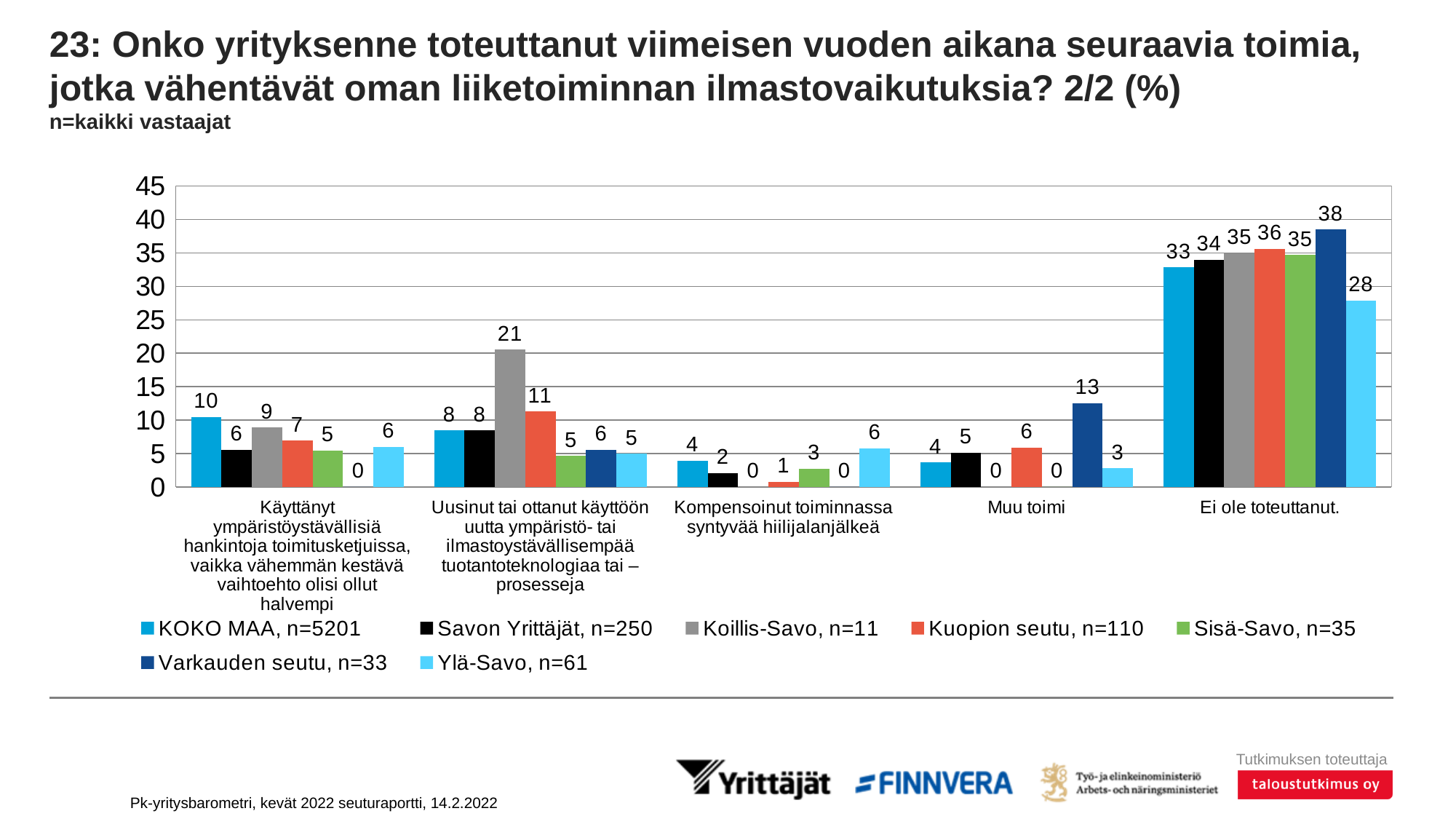
Which series has the highest value in the category "Muu toimi"? Varkauden seutu, n=33 What is the sample size (n) given in the legend for Kuopion seutu? n=110 Which series has the lowest value in the category "Ei ole toteuttanut."? Ylä-Savo, n=61 How many categories are shown on the x axis? 5 What is the value for Savon Yrittäjät in the category "Muu toimi"? 5 In the category "Kompensoinut toiminnassa syntyvää hiilijalanjälkeä", which is larger: the value for Ylä-Savo or the value for KOKO MAA? Ylä-Savo What is the value for Varkauden seutu in the category "Ei ole toteuttanut."? 38 What is the value for Koillis-Savo in the category "Uusinut tai ottanut käyttöön uutta ympäristö- tai ilmastoystävällisempää tuotantoteknologiaa tai -prosesseja"? 21 What is the difference between the Kuopion seutu and Ylä-Savo values in the category "Ei ole toteuttanut."? 8 What kind of chart is shown on the slide? Bar chart What is the value for KOKO MAA in the category "Käyttänyt ympäristöystävällisiä hankintoja toimitusketjuissa, vaikka vähemmän kestävä vaihtoehto olisi ollut halvempi"? 10 How many series does the legend list? 7